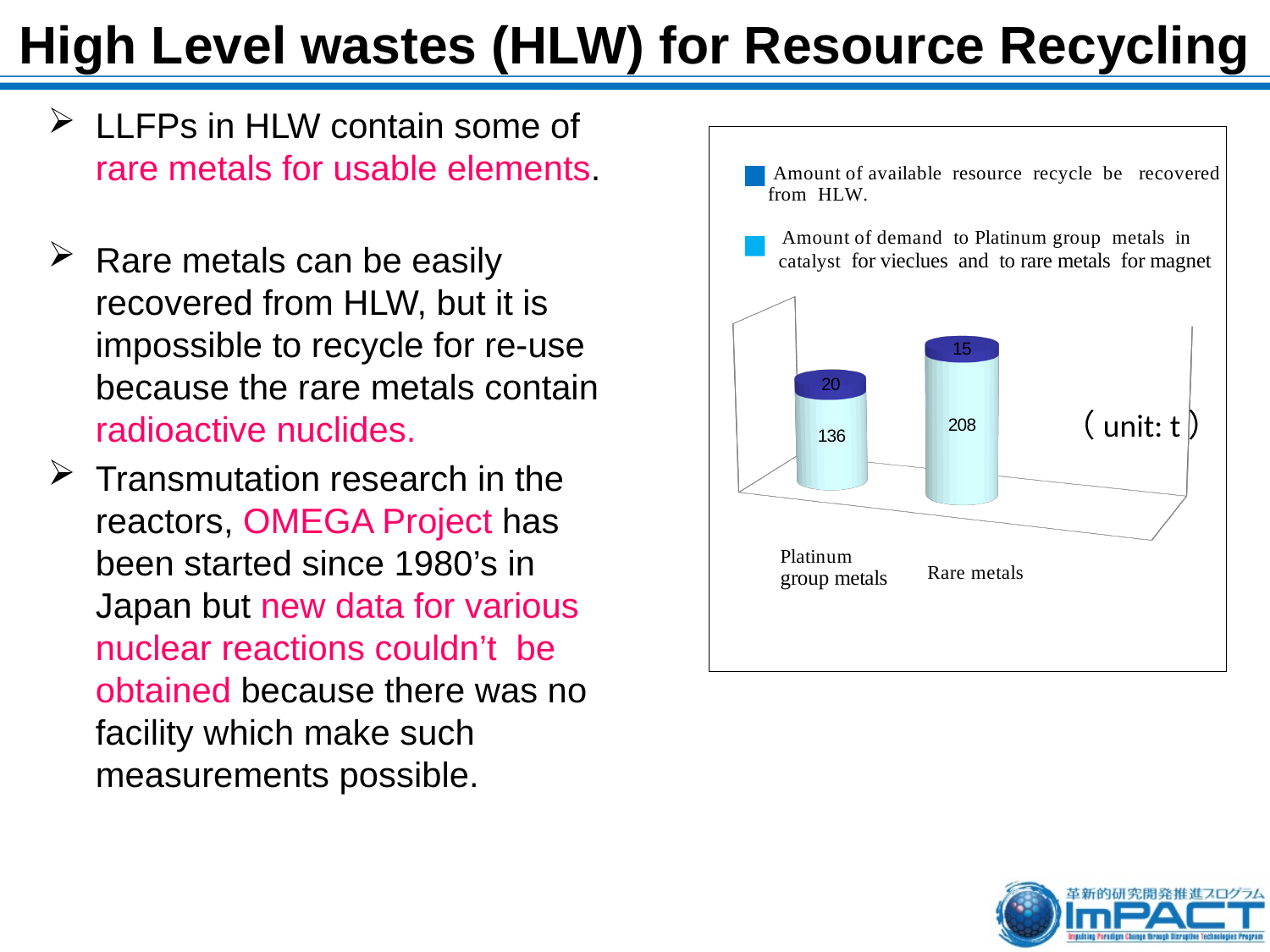
What is the amount of demand for Rare metals shown on the chart? 208 How many categories are shown on the chart? 2 What is the amount of available resource recovered from HLW for Platinum group metals? 20 What is the difference between the amount recovered from HLW for Platinum group metals and for Rare metals? 5 What is the amount of available resource recovered from HLW for Rare metals? 15 Which category has the higher demand value, Platinum group metals or Rare metals? Rare metals What is the total of the stacked bar for Rare metals? 223 What unit is indicated for the values on the chart? t What is the total of the stacked bar for Platinum group metals? 156 What is the difference between the demand for Rare metals and the demand for Platinum group metals? 72 Which category has the larger amount recovered from HLW? Platinum group metals What is the amount of demand for Platinum group metals shown on the chart? 136